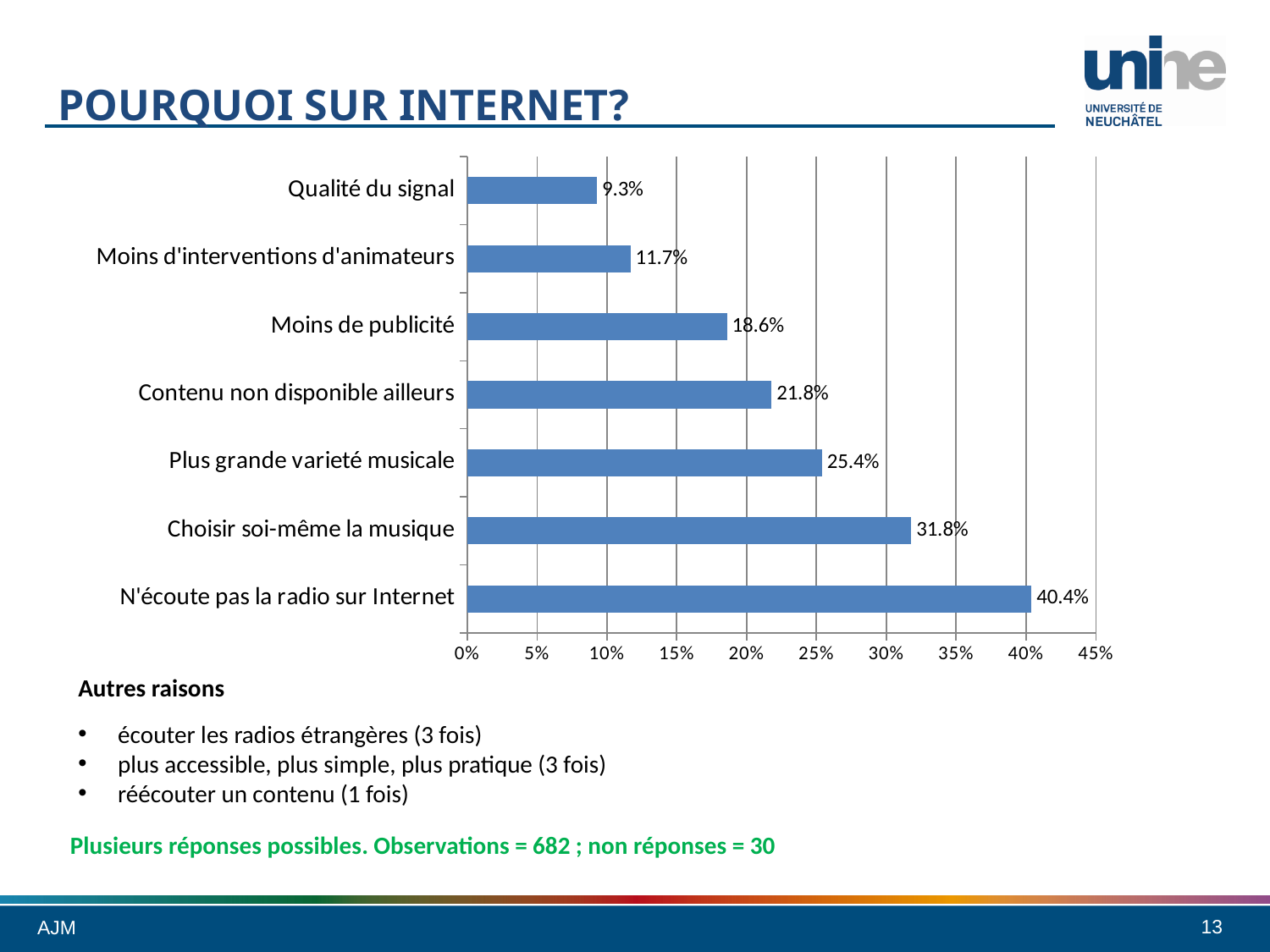
What is the value for "Choisir soi-même la musique"? 31.8% What is the maximum value shown on the horizontal axis? 45% How many categories are shown in the chart? 7 Which category has the lowest value? Qualité du signal Is the value for "Contenu non disponible ailleurs" greater or less than 20%? greater What is the value for "Moins de publicité"? 18.6% What is the difference between "Plus grande varieté musicale" and "Contenu non disponible ailleurs"? 3.6% Which category has the highest value? N'écoute pas la radio sur Internet What is the difference between "N'écoute pas la radio sur Internet" and "Choisir soi-même la musique"? 8.6% What is the value for "Qualité du signal"? 9.3% Which is larger: "Moins de publicité" or "Moins d'interventions d'animateurs"? Moins de publicité What kind of chart is shown on the slide? bar chart